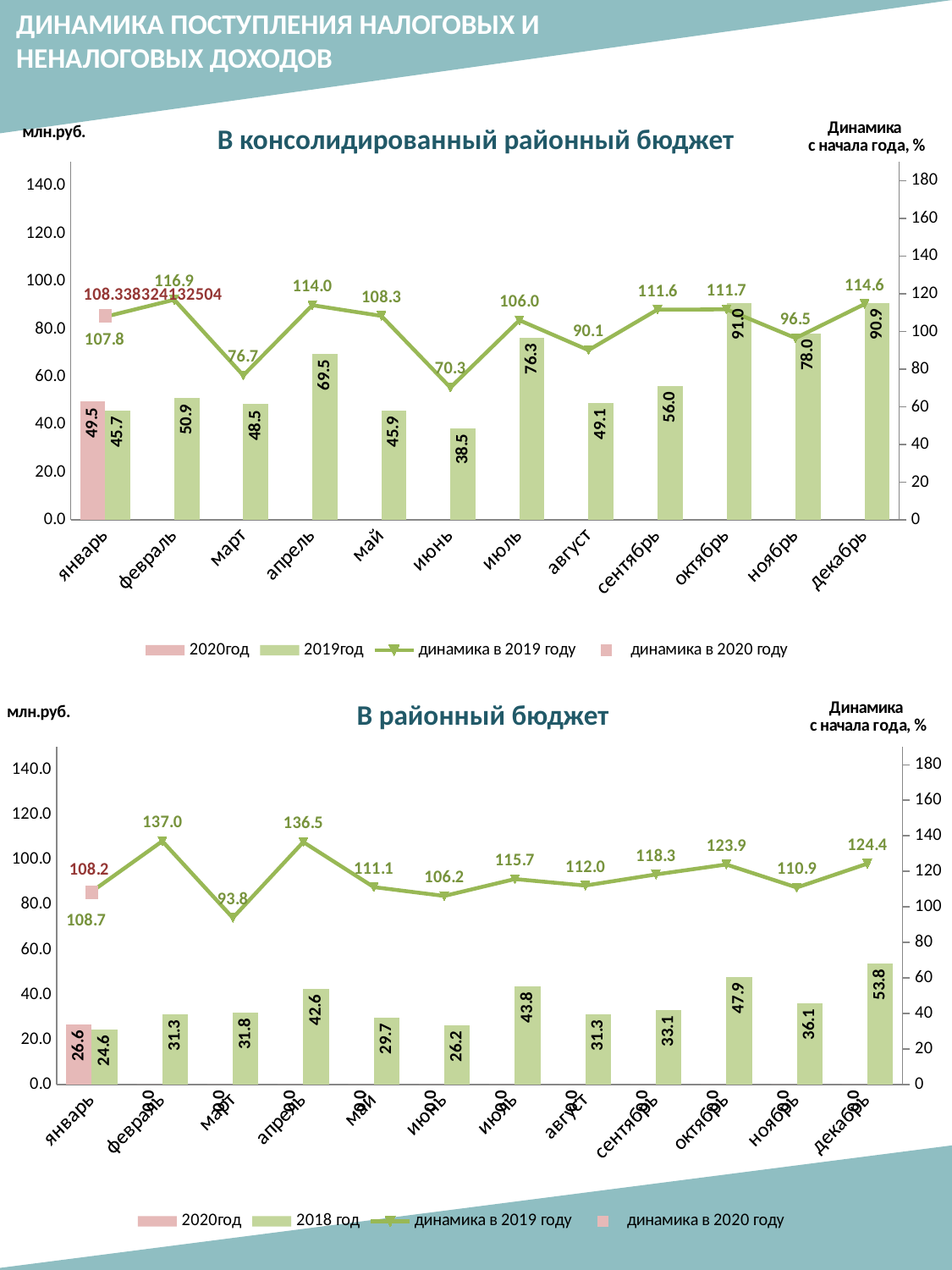
In the chart 'В консолидированный районный бюджет', what is the 2019 value for октябрь? 91.0 In the chart 'В районный бюджет', what is the 2018 value for декабрь? 53.8 In the chart 'В консолидированный районный бюджет', what is the value of 'динамика в 2019 году' for март? 76.7 In the chart 'В районный бюджет', how many months are shown on the x axis? 12 What kind of chart is 'В районный бюджет'? Combined bar and line chart In the chart 'В консолидированный районный бюджет', what is the difference between the 2020 and 2019 values for январь? 3.8 In the chart 'В консолидированный районный бюджет', which month has the highest 2019 bar? октябрь In the chart 'В консолидированный районный бюджет', which month has the lowest 2019 bar? июнь In the chart 'В районный бюджет', which is larger: the 2018 value for апрель or for июль? июль In the chart 'В районный бюджет', which month has the highest value of 'динамика в 2019 году'? февраль In the chart 'В консолидированный районный бюджет', how many entries does the legend list? 4 In the chart 'В районный бюджет', what is the value of 'динамика в 2020 году' for январь? 108.2